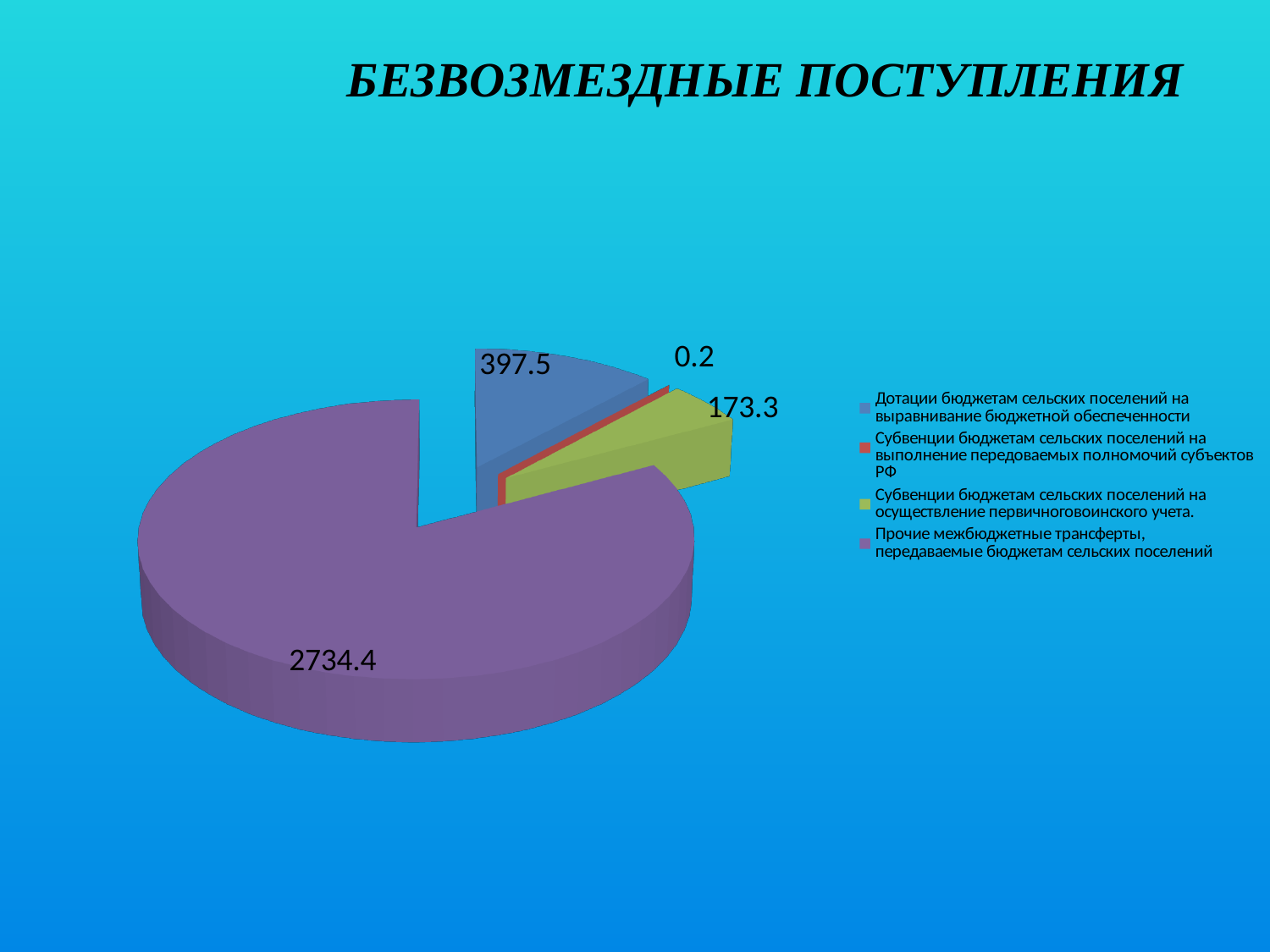
Which category has the largest slice of the pie? Прочие межбюджетные трансферты, передаваемые бюджетам сельских поселений How many categories does the pie chart have? 4 What is the value for Субвенции бюджетам сельских поселений на выполнение передаваемых полномочий субъектов РФ? 0.2 Which category has the smallest slice of the pie? Субвенции бюджетам сельских поселений на выполнение передаваемых полномочий субъектов РФ Which is larger: the value for Дотации бюджетам сельских поселений or the value for Субвенции на осуществление первичного воинского учета? Дотации бюджетам сельских поселений What is the total of all the values shown in the pie chart? 3305.4 What is the value for Дотации бюджетам сельских поселений на выравнивание бюджетной обеспеченности? 397.5 What is the title of the slide containing the chart? БЕЗВОЗМЕЗДНЫЕ ПОСТУПЛЕНИЯ What is the difference between the value for Прочие межбюджетные трансферты and the value for Дотации бюджетам сельских поселений? 2336.9 What is the value for Субвенции бюджетам сельских поселений на осуществление первичного воинского учета? 173.3 What kind of chart is shown on the slide? Pie chart What is the value for Прочие межбюджетные трансферты, передаваемые бюджетам сельских поселений? 2734.4